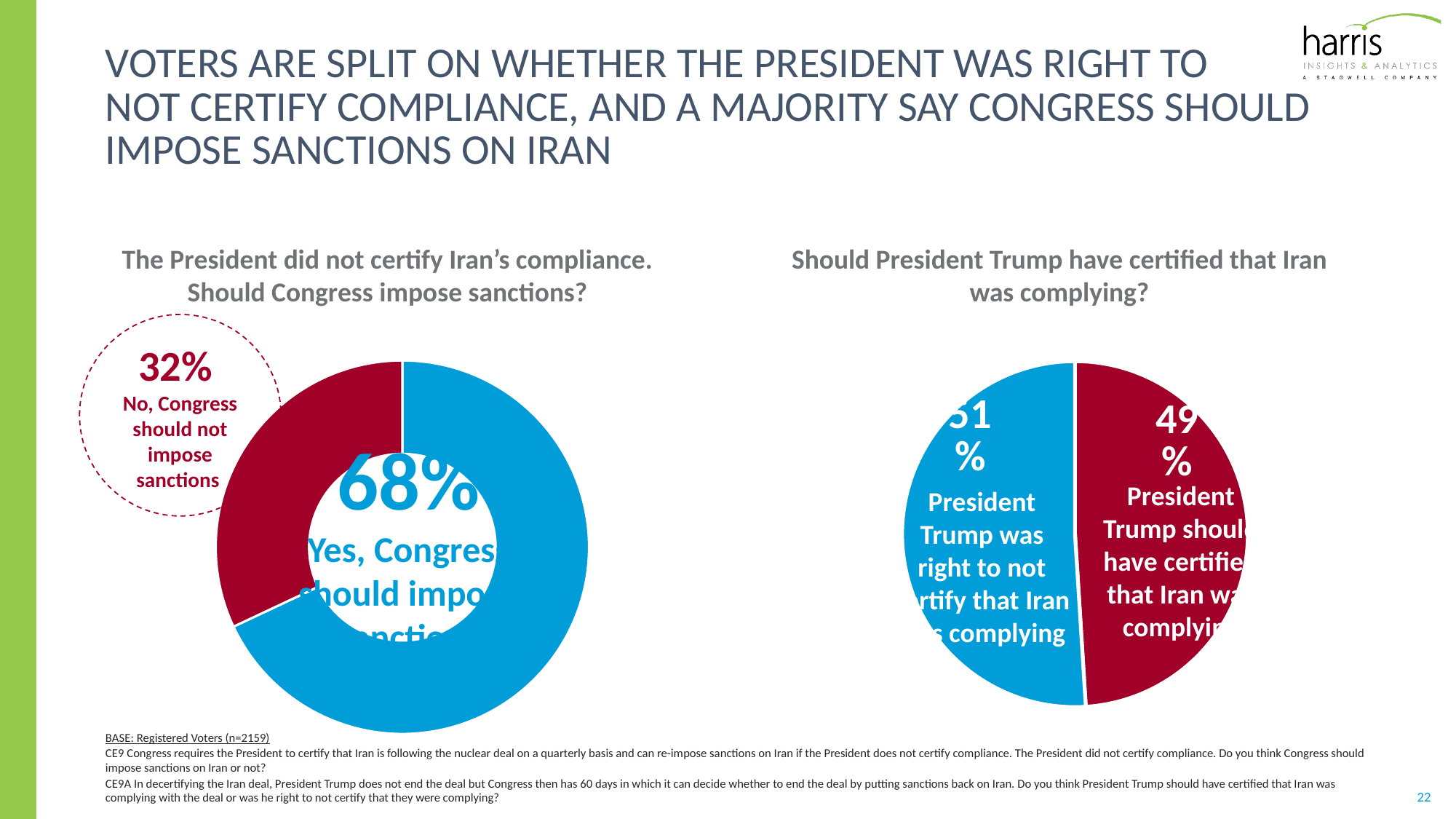
In the left chart about Congress imposing sanctions, which response has the larger share? Yes, Congress should impose sanctions In the right chart about whether Trump should have certified compliance, what is the difference in percentage points between the two responses? 2 percentage points What kind of chart is the right chart about whether Trump should have certified compliance? pie chart In the left chart about Congress imposing sanctions, what colour is the slice for No, Congress should not impose sanctions? red Is the share saying Yes, Congress should impose sanctions in the left chart larger or smaller than the share saying Trump was right to not certify in the right chart? larger In the chart titled "The President did not certify Iran's compliance. Should Congress impose sanctions?", what share of voters say Yes, Congress should impose sanctions? 68% In the left chart about Congress imposing sanctions, what is the difference in percentage points between the Yes and No shares? 36 percentage points How many slices does the right chart about whether Trump should have certified compliance have? 2 In the chart titled "Should President Trump have certified that Iran was complying?", what share say President Trump was right to not certify that Iran was complying? 51% In the chart titled "Should President Trump have certified that Iran was complying?", what share say President Trump should have certified that Iran was complying? 49% In the chart titled "The President did not certify Iran's compliance. Should Congress impose sanctions?", what share of voters say No, Congress should not impose sanctions? 32% In the right chart about whether Trump should have certified compliance, which response has the smaller share? President Trump should have certified that Iran was complying